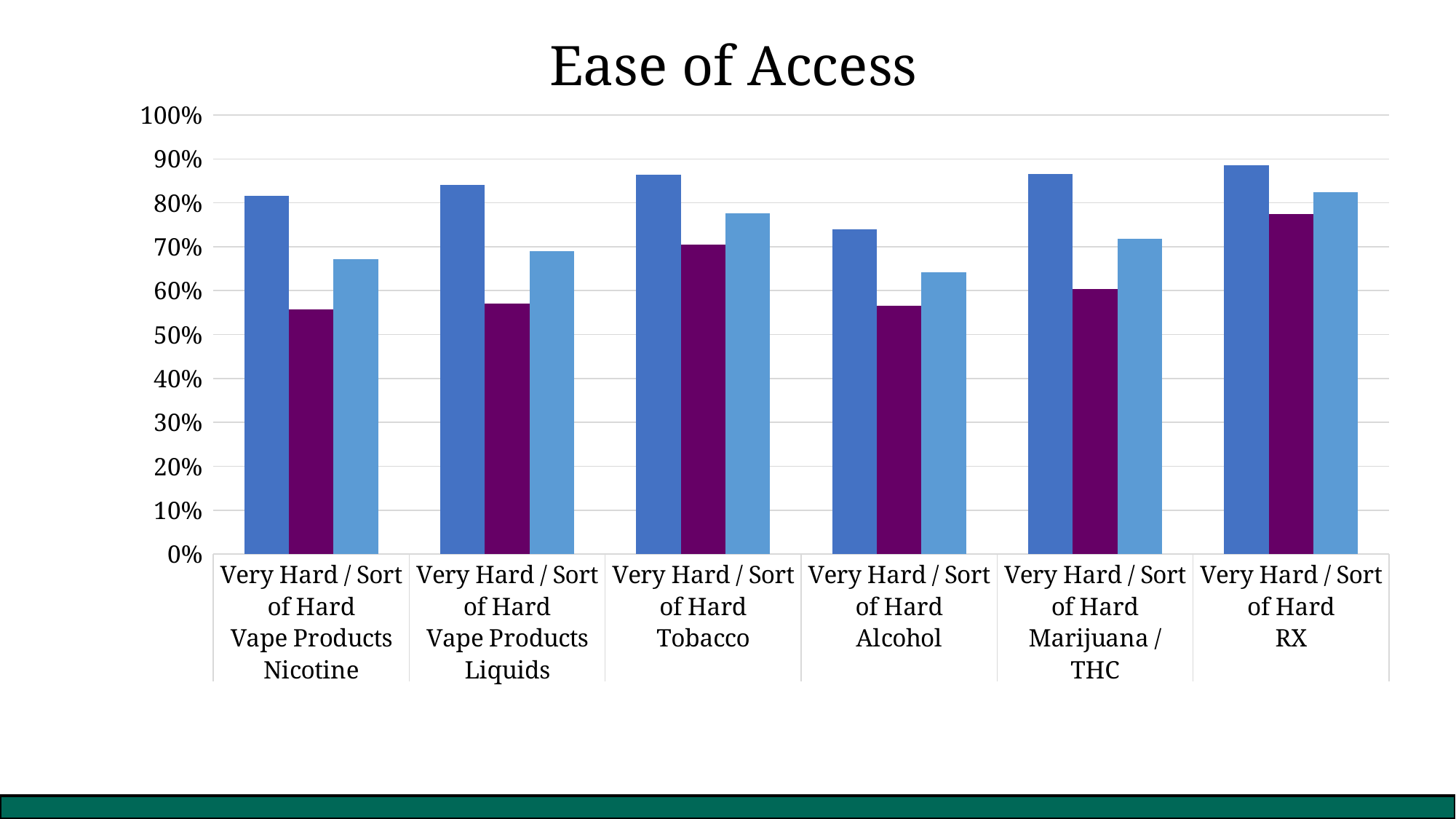
Is the dark blue bar for RX greater or less than 80%? greater What kind of chart is shown on the slide? bar chart Is the purple bar for Tobacco greater or less than 60%? greater Which category has the lowest dark blue bar? Alcohol How many bars are plotted for each category? 3 Which is larger: the dark blue bar for Tobacco or the dark blue bar for Alcohol? Tobacco What is the title of the chart? Ease of Access Within the Tobacco category, which is larger: the purple bar or the light blue bar? the light blue bar Is the purple bar for Vape Products Nicotine greater or less than 60%? less How many categories are shown along the x axis? 6 Which category has the highest purple bar? RX